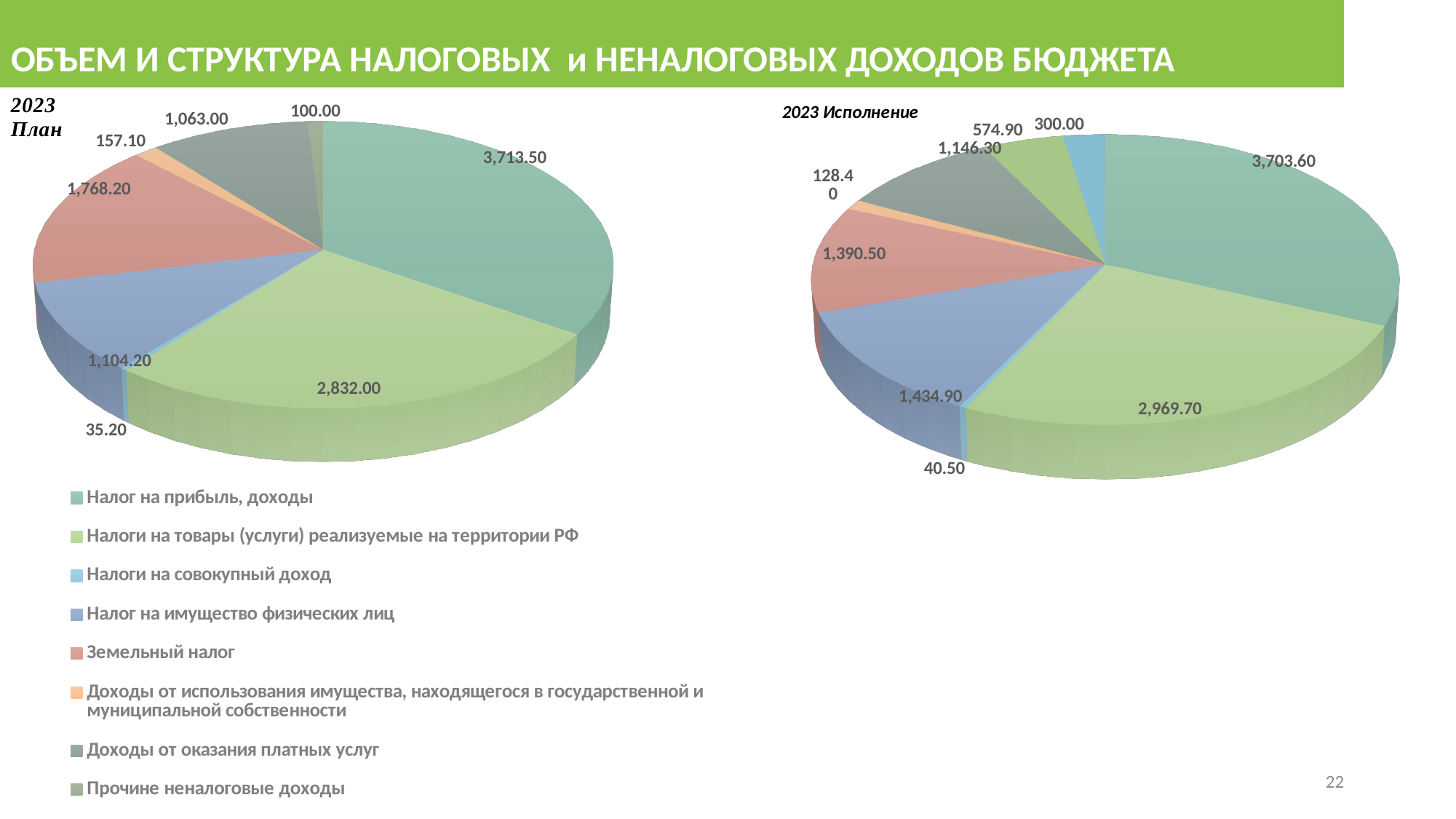
In the 2023 Исполнение chart, what is the value for Доходы от оказания платных услуг? 1,146.30 In the 2023 План chart, what is the value for Налог на прибыль, доходы? 3,713.50 In the 2023 Исполнение chart, which is larger: Налог на имущество физических лиц or Земельный налог? Налог на имущество физических лиц How many slices does the 2023 План pie chart have? 8 In the 2023 План chart, which category has the largest slice? Налог на прибыль, доходы In the 2023 Исполнение chart, what is the difference between Налог на прибыль, доходы and Налоги на товары (услуги) реализуемые на территории РФ? 733.90 In the 2023 План chart, which category has the smallest slice? Налоги на совокупный доход In the 2023 План chart, what is the value for Земельный налог? 1,768.20 How many categories does the legend list? 8 In the 2023 Исполнение chart, what is the value for Налоги на товары (услуги) реализуемые на территории РФ? 2,969.70 What kind of charts are shown on the slide? Pie charts In the 2023 План chart, what is the difference between Налог на прибыль, доходы and Налоги на товары (услуги) реализуемые на территории РФ? 881.50